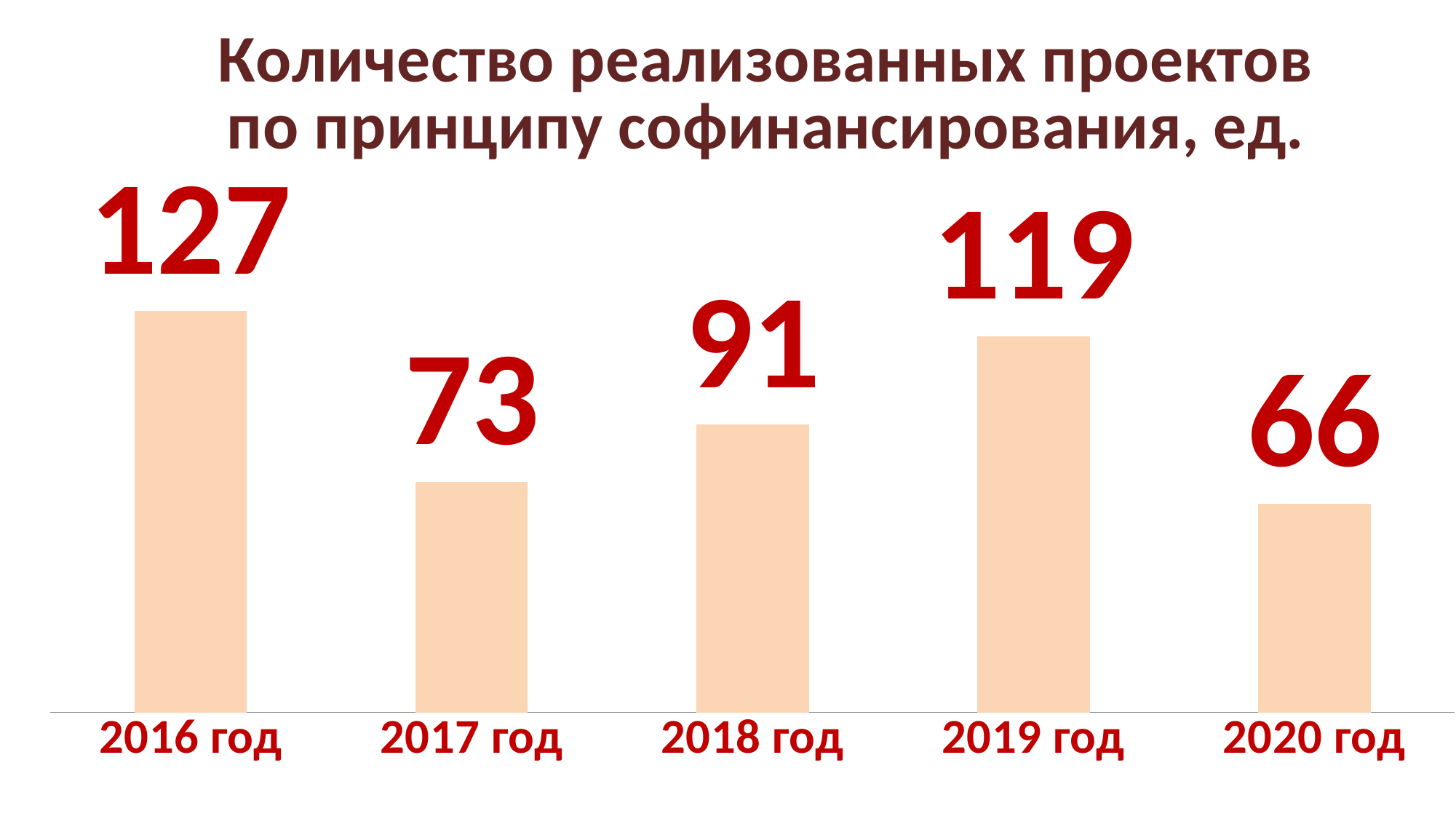
What is the value for 2019 год? 119 How many years are shown on the chart? 5 What is the value for 2020 год? 66 Which year has the highest value? 2016 год Which is larger, the value for 2017 год or the value for 2018 год? 2018 год What is the difference between the values for 2016 год and 2019 год? 8 What is the value for 2017 год? 73 What is the value for 2018 год? 91 What is the title of the chart? Количество реализованных проектов по принципу софинансирования, ед. What is the value for 2016 год? 127 What kind of chart is shown on the slide? bar chart Which year has the lowest value? 2020 год